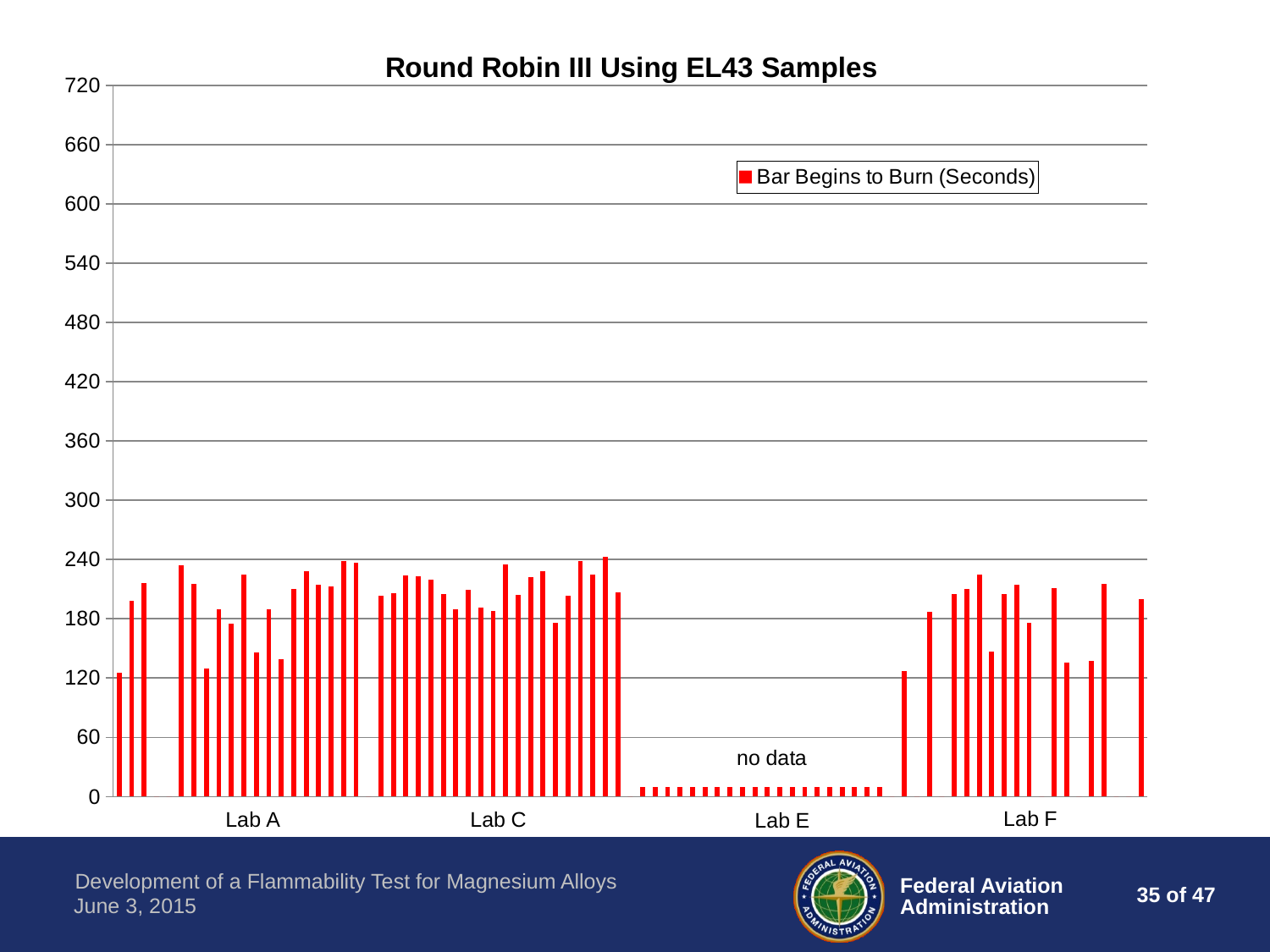
Is the tallest bar for Lab F greater or less than 240? less Is the tallest bar for Lab A greater or less than 180? greater Is the shortest bar for Lab A greater or less than 180? less How many labs are labeled along the x axis? 4 What is the name of the series shown in the legend? Bar Begins to Burn (Seconds) Which lab is marked as having no data? Lab E What kind of chart is shown on the slide? Bar chart How many series does the legend list? 1 What is the title of the chart? Round Robin III Using EL43 Samples What is the maximum value shown on the y axis? 720